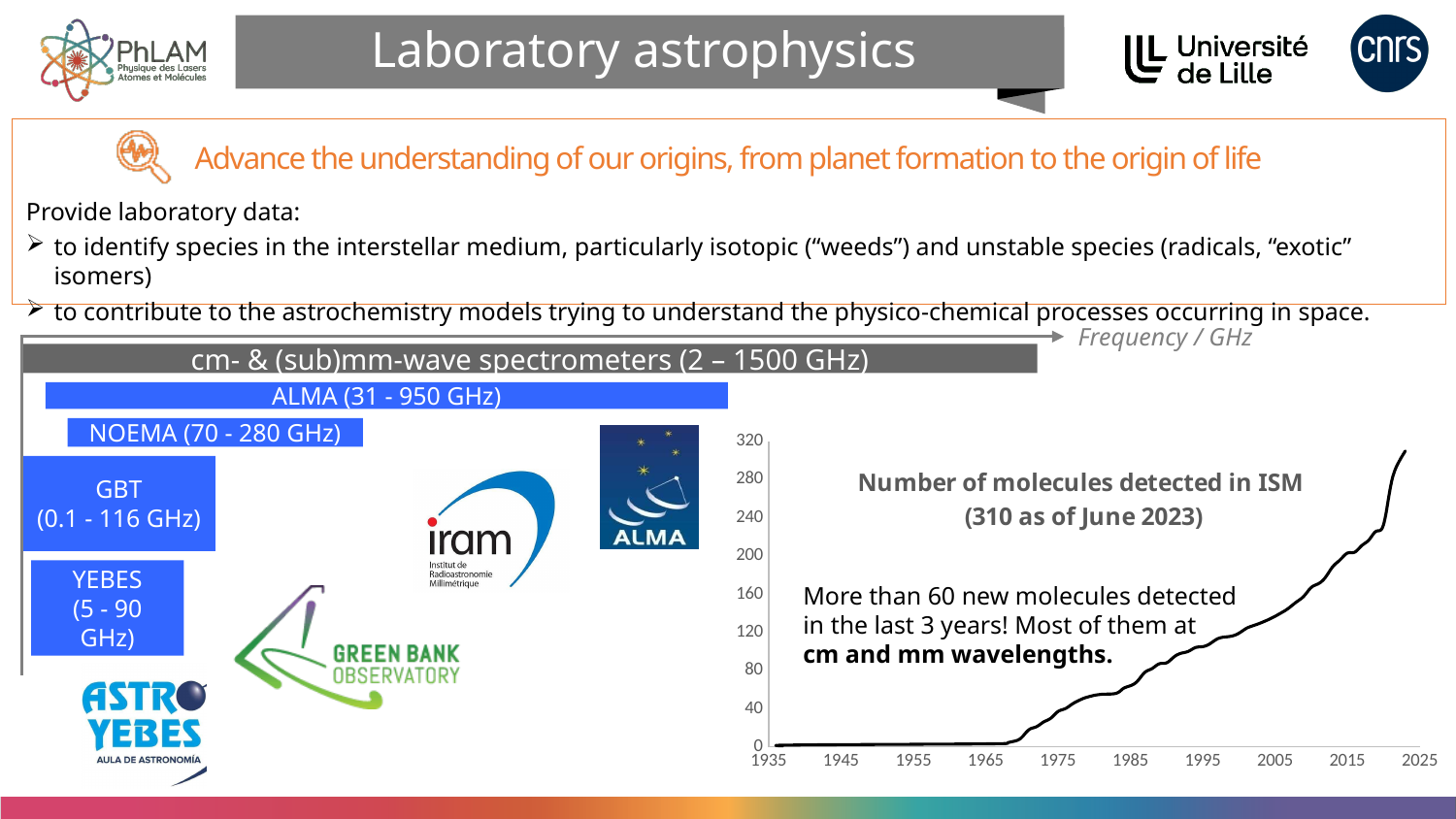
In the frequency-range diagram on the left of the slide, what frequency range is given for NOEMA? 70 - 280 GHz In the 'Number of molecules detected in ISM' chart, does the number of molecules rise or fall from 1935 to 2025? rise In the 'Number of molecules detected in ISM' chart, is the value for 1985 greater or less than 160? less In the 'Number of molecules detected in ISM' chart, what is the highest value shown on the y axis? 320 According to the 'Number of molecules detected in ISM' chart, how many molecules had been detected as of June 2023? 310 In the 'Number of molecules detected in ISM' chart, what are the first and last years labelled on the x axis? 1935 and 2025 In the 'Number of molecules detected in ISM' chart, is the value at the end of the line (around 2025) greater or less than 280? greater In the frequency-range diagram on the left of the slide, what frequency range is given for ALMA? 31 - 950 GHz What kind of chart is the 'Number of molecules detected in ISM' chart? line chart In the 'Number of molecules detected in ISM' chart, which year has the larger value, 1975 or 2015? 2015 In the 'Number of molecules detected in ISM' chart, is the value for 1975 greater or less than 80? less